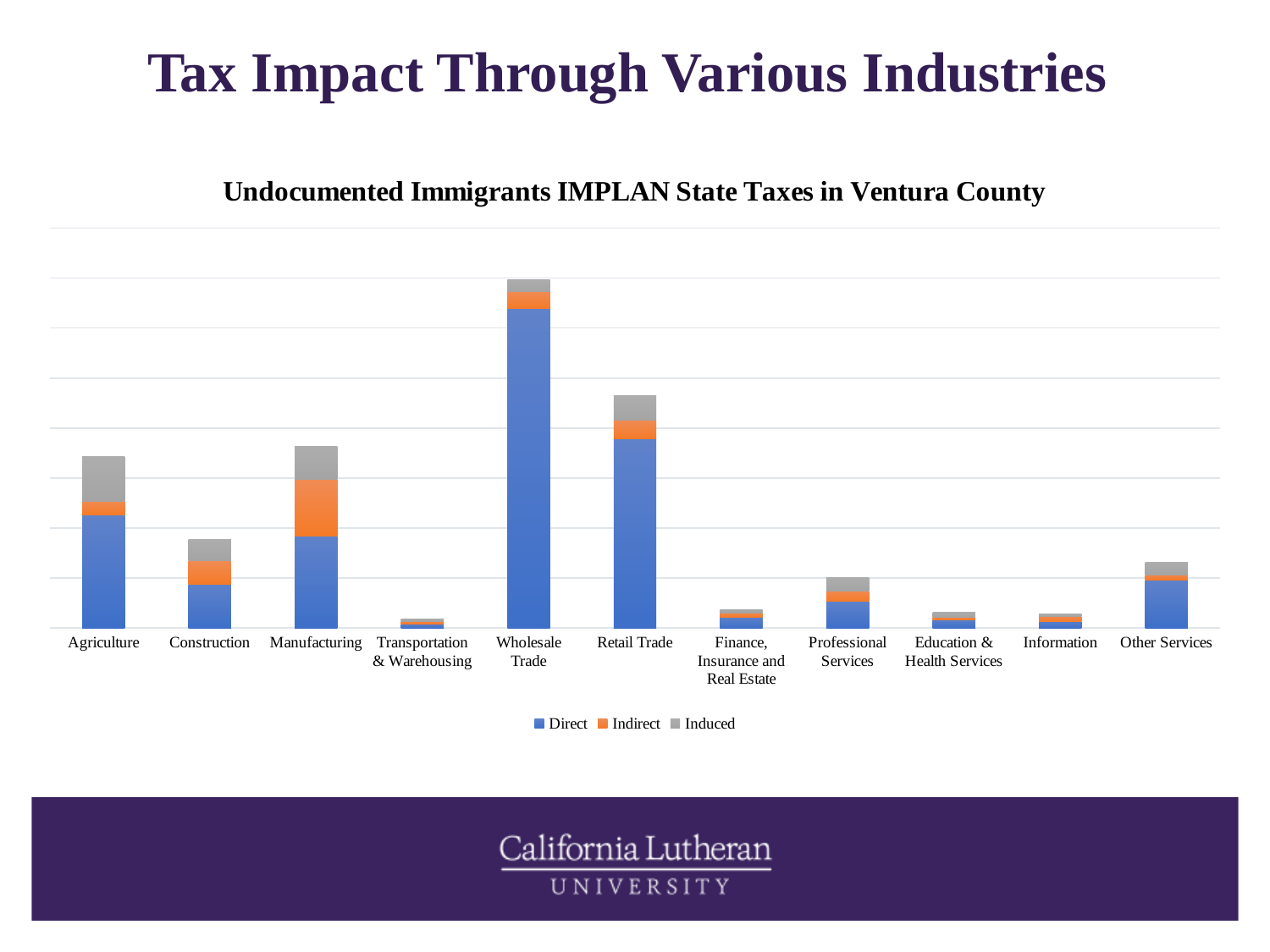
Which has a larger total bar, Wholesale Trade or Retail Trade? Wholesale Trade Which has a larger total bar, Agriculture or Construction? Agriculture How many industry categories are shown on the x axis? 11 What is the title of the chart? Undocumented Immigrants IMPLAN State Taxes in Ventura County Which industry has the largest Direct segment? Wholesale Trade How many series does the legend list? 3 Which industry has the highest total state tax impact? Wholesale Trade Which has a larger total bar, Retail Trade or Manufacturing? Retail Trade What are the three series named in the legend? Direct, Indirect, Induced What kind of chart is shown on the slide? Stacked bar chart Which industry has the largest Indirect segment? Manufacturing